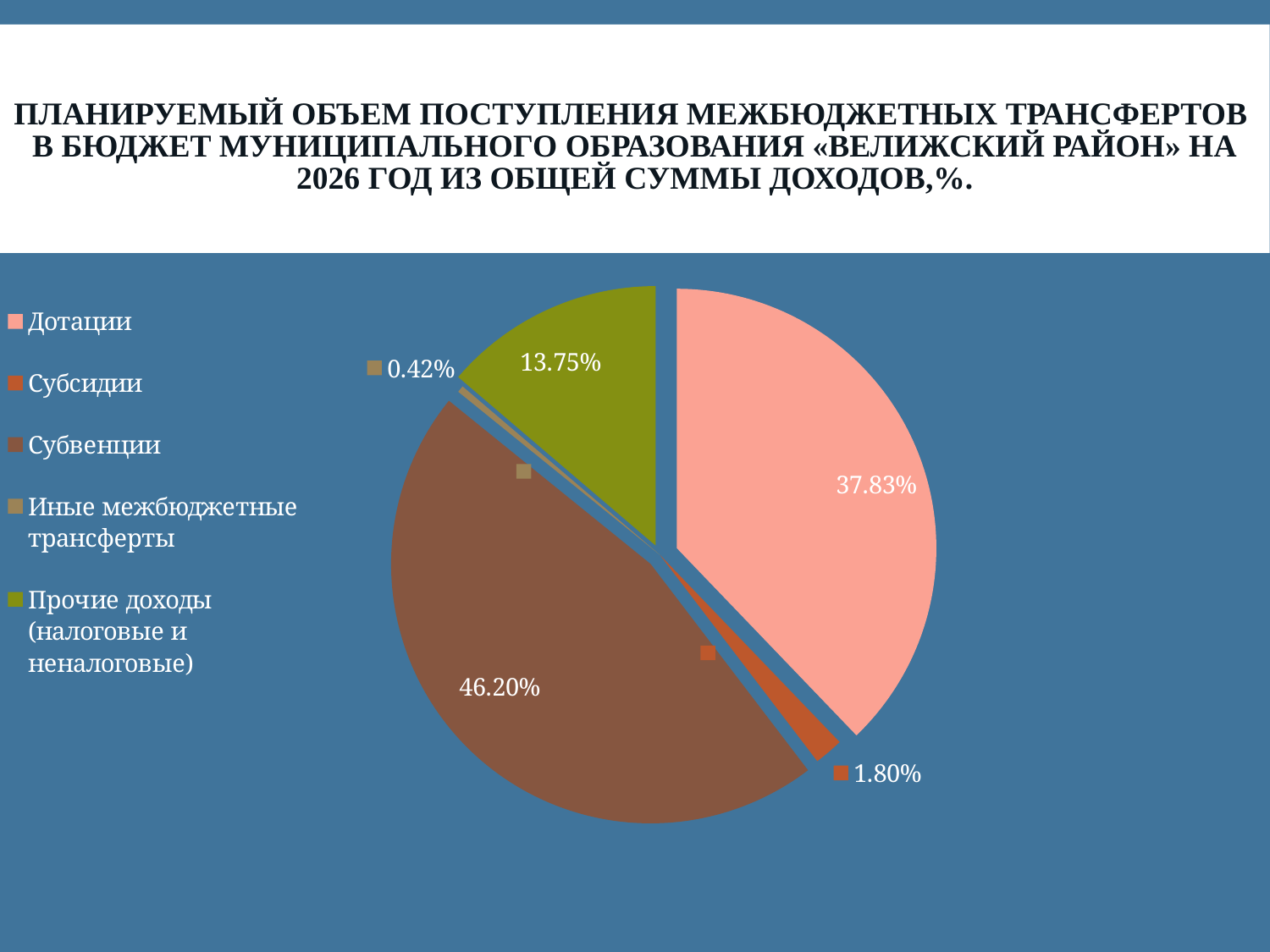
What is the value for Иные межбюджетные трансферты? 0.42% What is the value for Субсидии? 1.80% Which category has the smallest share of the pie? Иные межбюджетные трансферты What is the value for Дотации? 37.83% What kind of chart is shown on the slide? Pie chart What is the difference between the values for Субвенции and Дотации? 8.37% How many categories does the pie chart show? 5 What is the value for Прочие доходы (налоговые и неналоговые)? 13.75% What is the value for Субвенции? 46.20% Which category has the largest share of the pie? Субвенции Which is larger, the value for Прочие доходы (налоговые и неналоговые) or the value for Субсидии? Прочие доходы (налоговые и неналоговые) What colour is the slice for Прочие доходы (налоговые и неналоговые)? Green